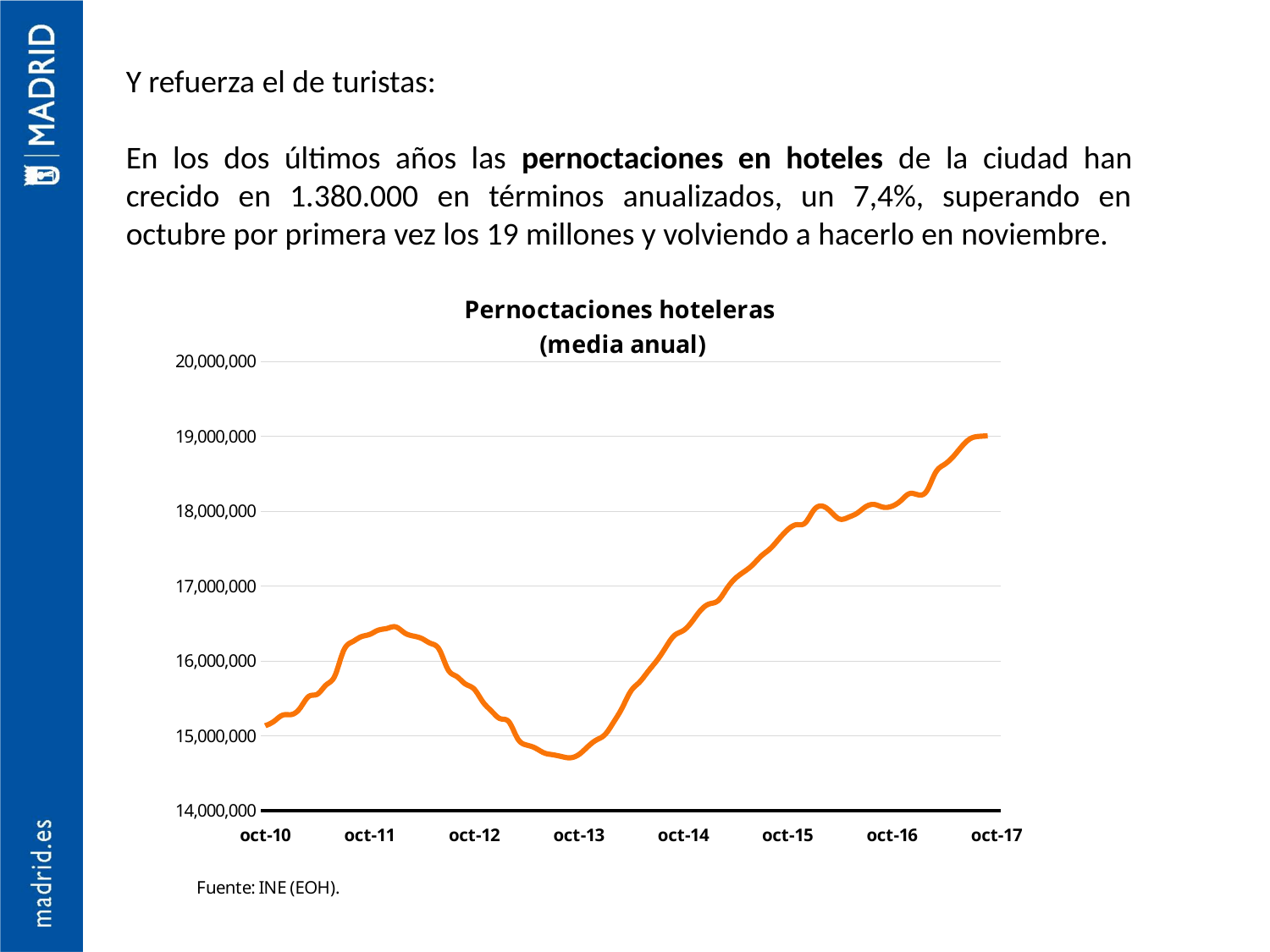
How many date labels are shown on the x axis of the chart? 8 Is the value for oct-14 greater or less than 16,000,000? greater Do the values rise or fall between oct-11 and oct-13? fall What kind of chart is shown on the slide? line chart Is the value for oct-10 greater or less than 15,000,000? greater Is the value for oct-13 greater or less than 15,000,000? less Which is larger, the value for oct-17 or the value for oct-10? oct-17 Overall, do the values rise or fall from oct-10 to oct-17? rise What is the title of the chart? Pernoctaciones hoteleras (media anual) Which is larger, the value for oct-11 or the value for oct-13? oct-11 What colour is the line plotted in the chart? orange